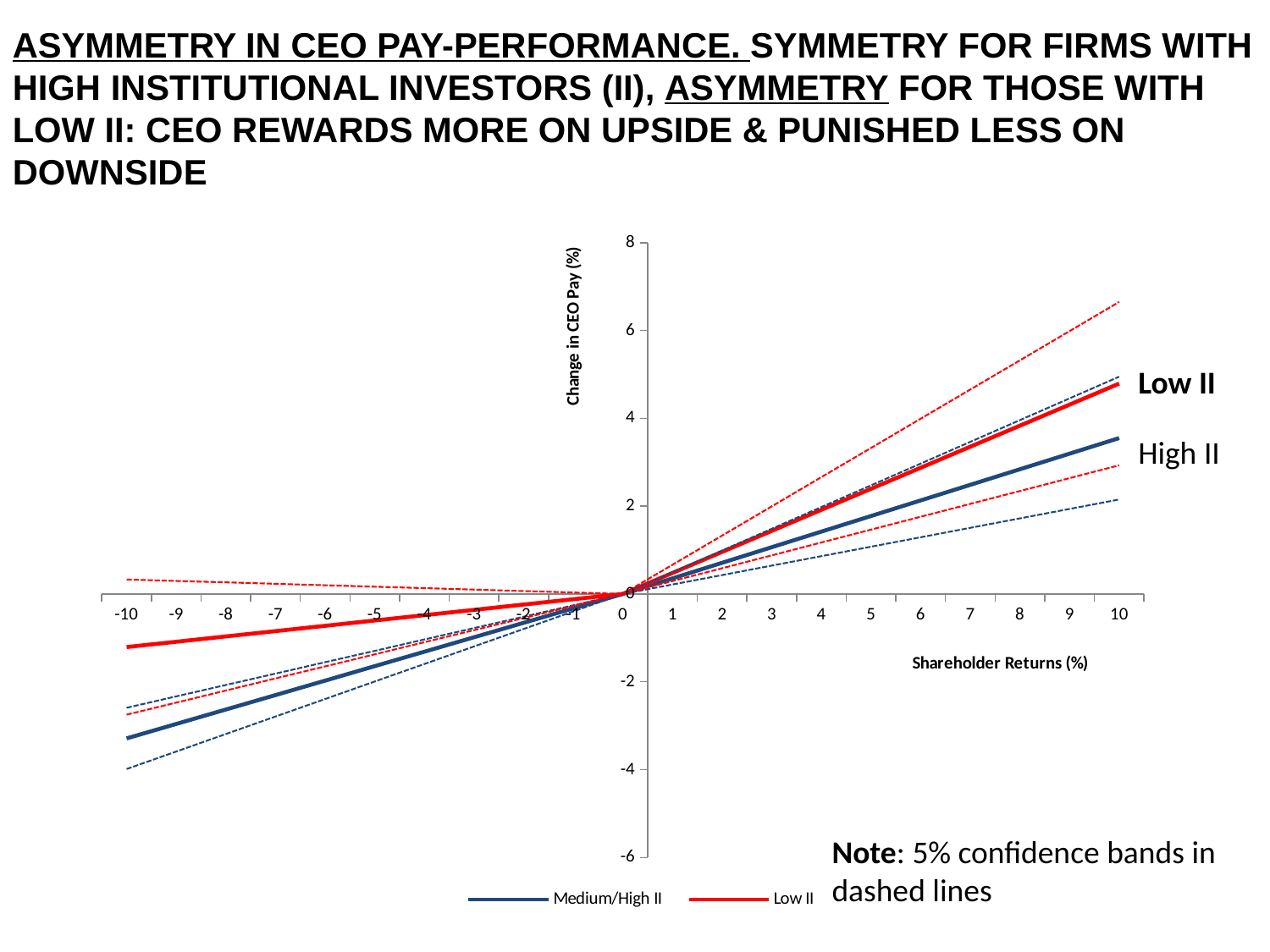
At Shareholder Returns of -10, is the Medium/High II line greater or less than -2 on the Change in CEO Pay axis? less What is the title of the horizontal axis of the chart? Shareholder Returns (%) At Shareholder Returns of 10, is the Low II line greater or less than 4 on the Change in CEO Pay axis? greater At Shareholder Returns of 10, is the Medium/High II line greater or less than 4 on the Change in CEO Pay axis? less What is the title of the vertical axis of the chart? Change in CEO Pay (%) At Shareholder Returns of 10, which series shows the larger Change in CEO Pay, Low II or Medium/High II? Low II What kind of chart is shown on the slide? line chart At Shareholder Returns of -10, which series shows the lower (more negative) Change in CEO Pay, Low II or Medium/High II? Medium/High II How many series does the chart legend list? 2 Does the Medium/High II line rise or fall as Shareholder Returns increase from -10 to 10? rise Does the Low II line rise or fall as Shareholder Returns increase from -10 to 10? rise